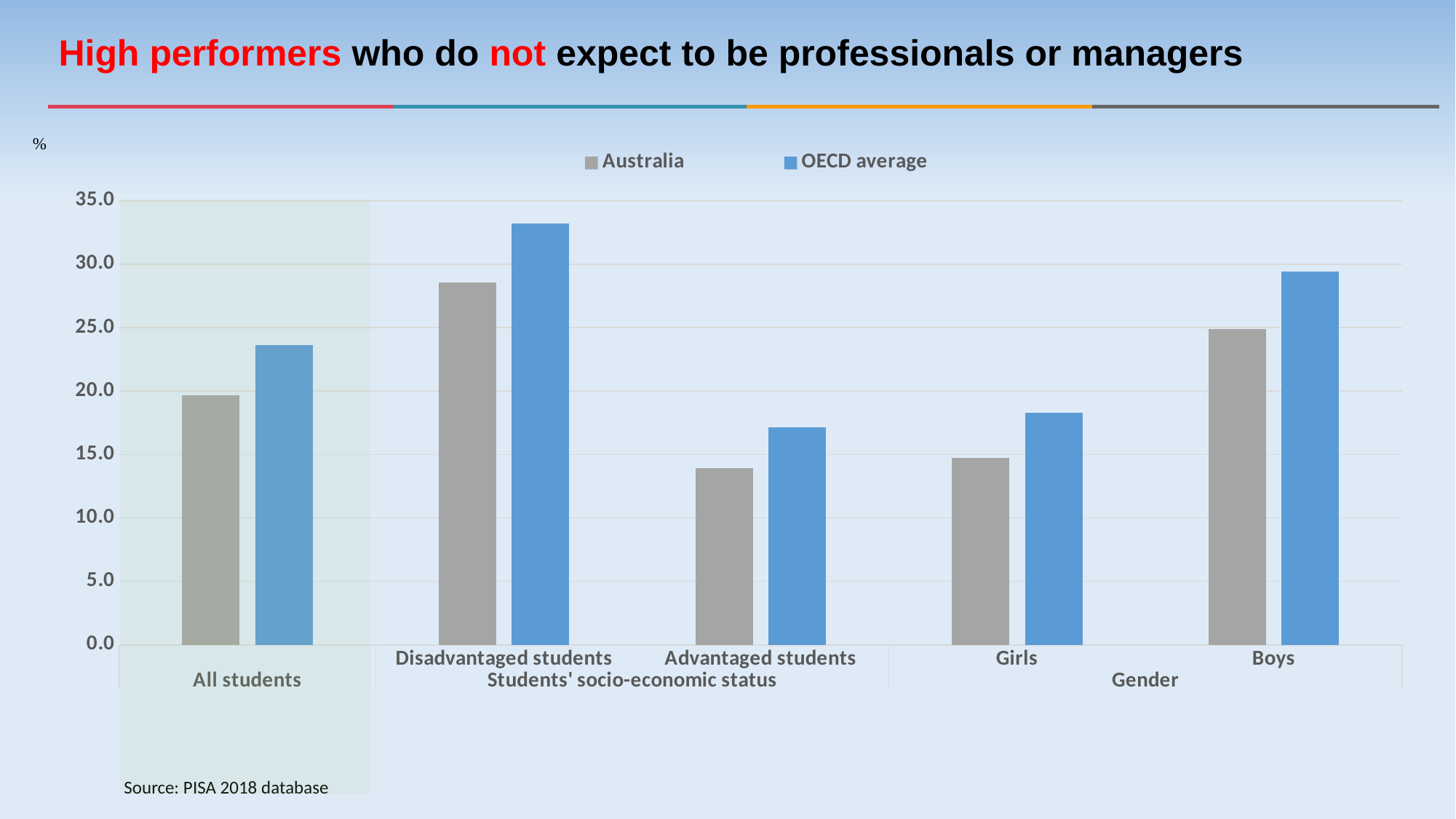
Which category has the highest value for the OECD average? Disadvantaged students Is the OECD average value for Disadvantaged students greater or less than 30.0? greater Is the Australia value for Advantaged students greater or less than 15.0? less Which series is shown in blue in the legend? OECD average Is the OECD average value for Boys greater or less than 25.0? greater How many student categories are plotted along the x axis? 5 For Australia, which is larger: the value for Boys or the value for Girls? Boys For All students, which is larger: the Australia value or the OECD average value? OECD average What kind of chart is shown on the slide? bar chart How many series does the legend list? 2 Which category has the highest value for Australia? Disadvantaged students